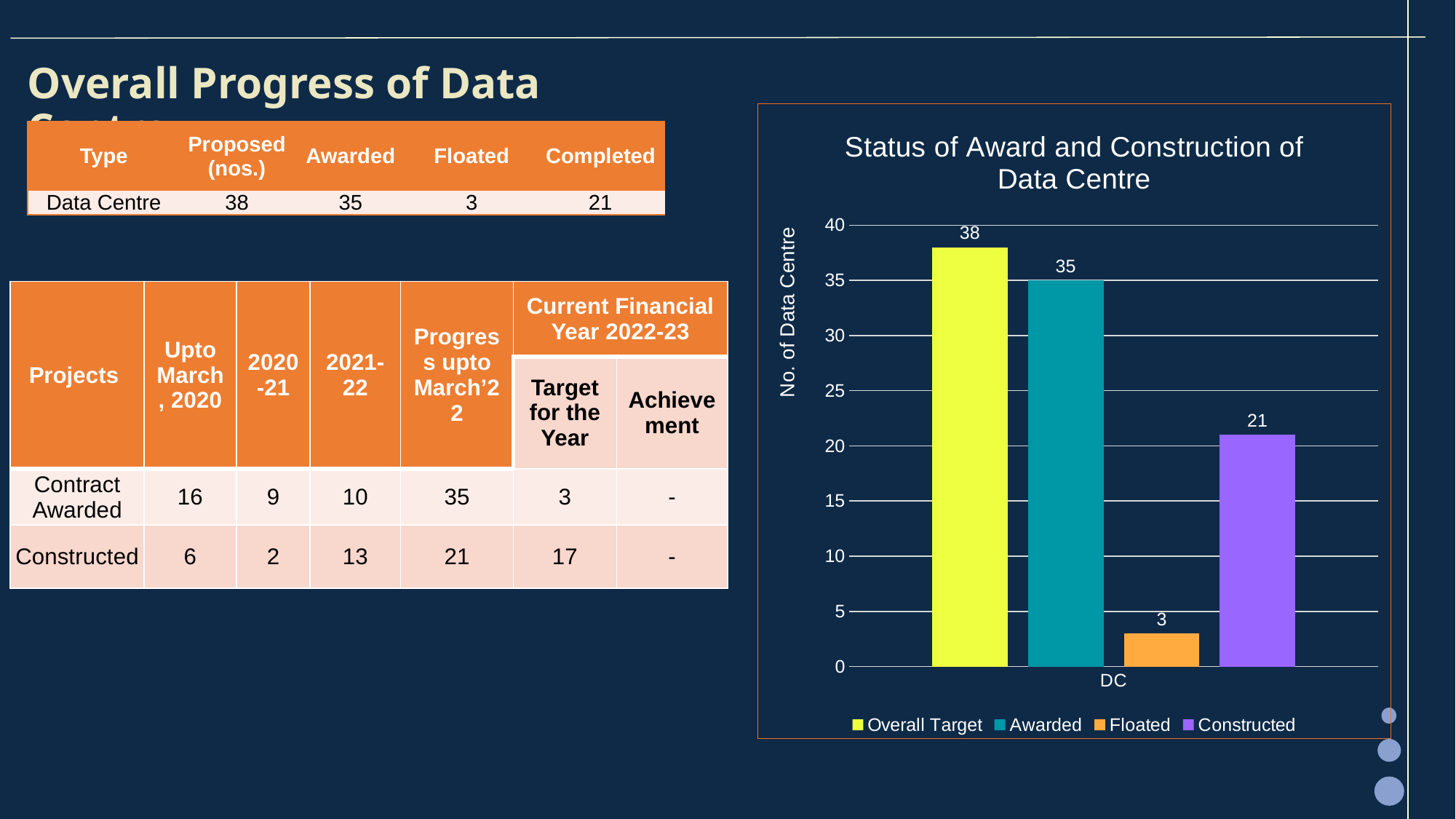
Which is larger in the chart, Constructed or Floated? Constructed Which series has the highest value in the chart? Overall Target What is the title of the chart? Status of Award and Construction of Data Centre What is the value of the Floated series in the chart? 3 What type of chart is shown on the slide? Bar chart What is the difference between the Overall Target and Awarded values in the chart? 3 Which series has the lowest value in the chart? Floated What is the value of the Awarded series in the chart? 35 How many series does the chart legend list? 4 What is the difference between the Awarded and Constructed values in the chart? 14 What is the value of the Overall Target series in the chart? 38 What is the value of the Constructed series in the chart? 21